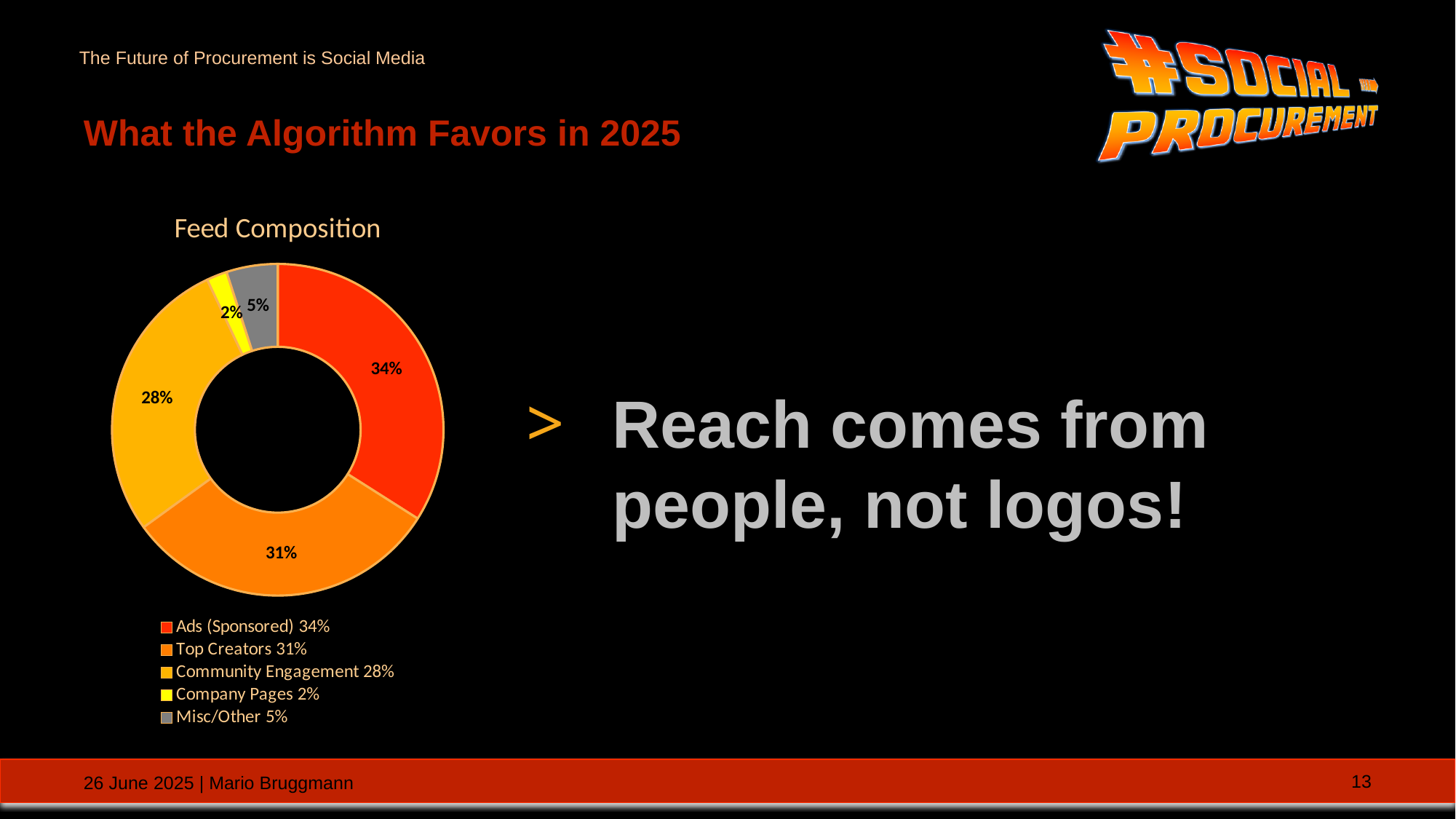
How many categories does the Feed Composition chart show? 5 Which category has the smallest share of the feed composition? Company Pages What share of the feed composition is Company Pages? 2% What type of chart is shown under the title "Feed Composition"? Doughnut (pie) chart What share of the feed composition is Misc/Other? 5% What share of the feed composition is Community Engagement? 28% What share of the feed composition is Top Creators? 31% Which category has the largest share of the feed composition? Ads (Sponsored) What share of the feed composition is Ads (Sponsored)? 34% Which is larger in the feed composition: Misc/Other or Company Pages? Misc/Other What is the difference in percentage points between Ads (Sponsored) and Community Engagement? 6 percentage points What is the title of the chart on the slide? Feed Composition